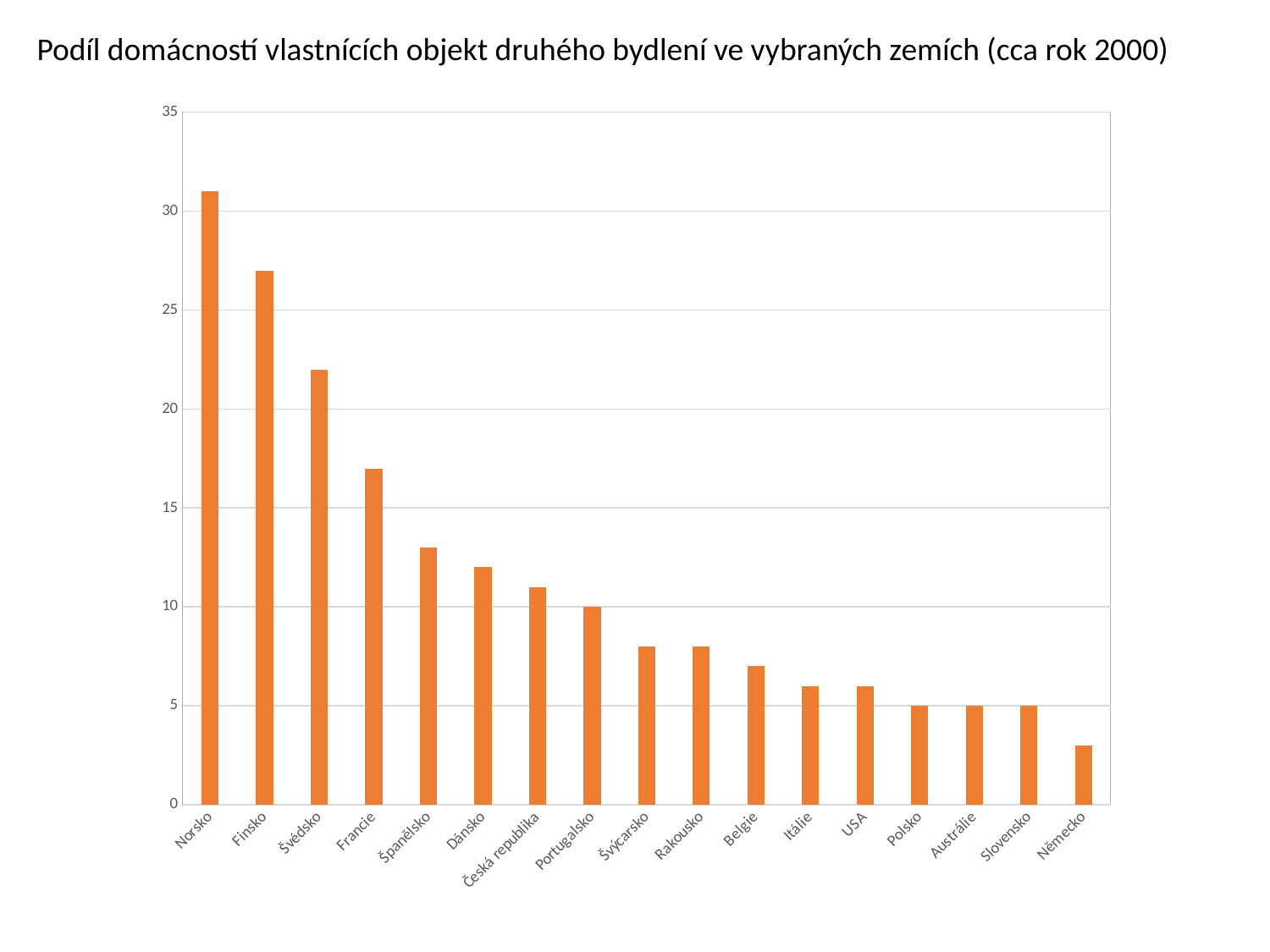
How many countries are shown on the x axis of the chart? 17 Is the value for Norsko greater or less than 30? greater Is the value for Francie greater or less than 15? greater Is the value for Německo greater or less than 5? less Which country has the highest value in the chart? Norsko What is the value for Polsko? 5 What is the title of the chart? Podíl domácností vlastnících objekt druhého bydlení ve vybraných zemích (cca rok 2000) What is the value for Portugalsko? 10 Which country has the lowest value in the chart? Německo Which has a larger value, Norsko or Finsko? Norsko What kind of chart is shown on the slide? bar chart Do the values rise or fall from left to right along the x axis? fall